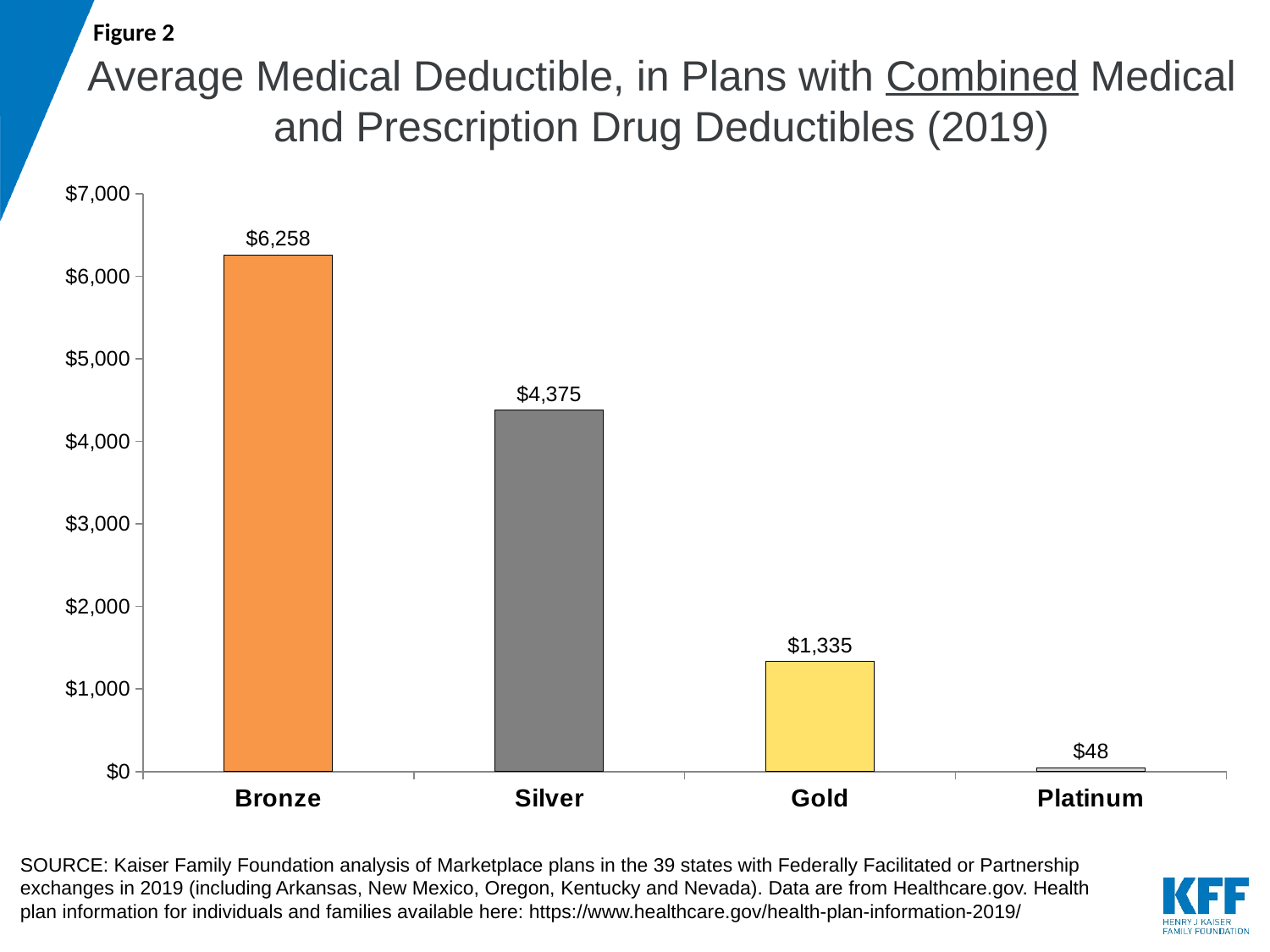
What is the average medical deductible for Bronze plans? $6,258 Which has a larger average medical deductible, Silver or Gold? Silver Which plan type has the highest average medical deductible? Bronze What kind of chart is shown on the slide? Bar chart How many plan types are shown on the chart? 4 What is the difference between the Gold and Platinum average medical deductibles? $1,287 What is the difference between the Bronze and Silver average medical deductibles? $1,883 What is the average medical deductible for Platinum plans? $48 What is the average medical deductible for Gold plans? $1,335 What is the average medical deductible for Silver plans? $4,375 Do the values rise or fall moving from Bronze to Platinum along the x axis? Fall Which plan type has the lowest average medical deductible? Platinum